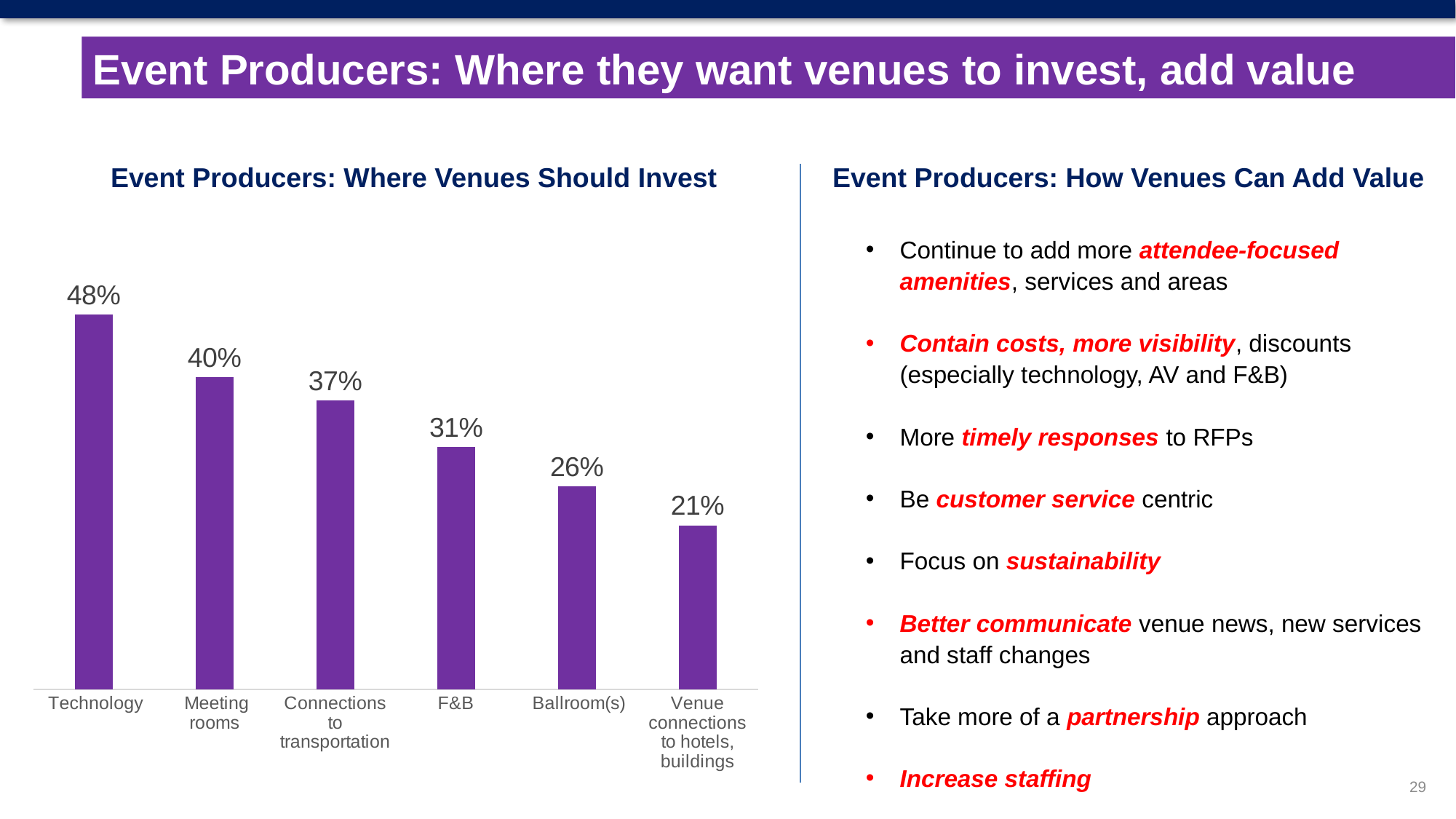
Which is larger, the value for F&B or the value for Ballroom(s)? F&B Do the values rise or fall from left to right across the categories? Fall What is the difference between the values for Technology and F&B? 17% What is the value for Meeting rooms? 40% What is the difference between the values for Meeting rooms and Ballroom(s)? 14% How many categories are shown in the chart? 6 Which category has the highest value? Technology What is the value for Ballroom(s)? 26% Which category has the lowest value? Venue connections to hotels, buildings What percentage of event producers say venues should invest in Technology? 48% What is the value for Connections to transportation? 37% What kind of chart is shown on the slide? Bar chart